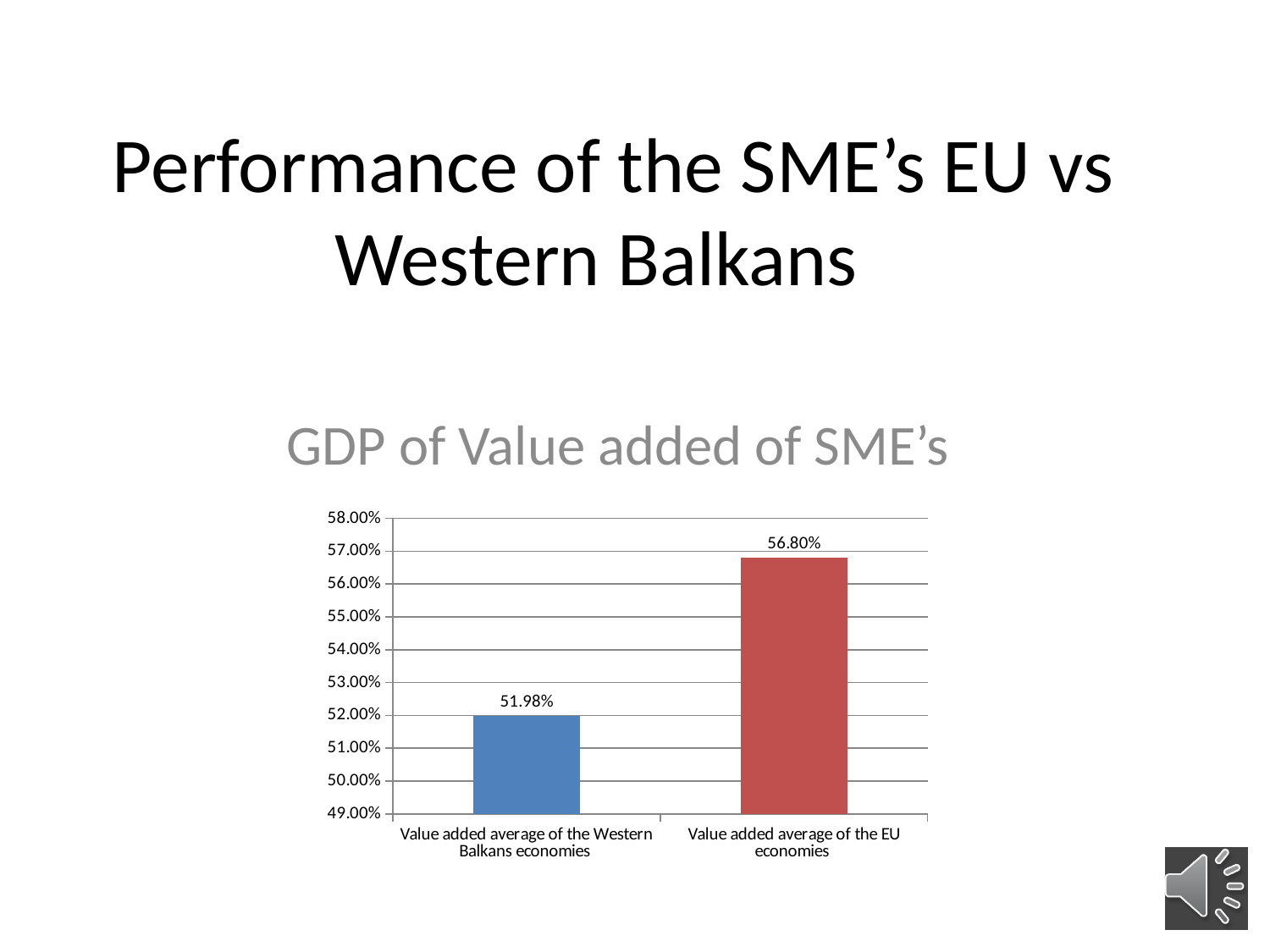
What kind of chart is shown on the slide? bar chart Which category has the higher value? Value added average of the EU economies How many categories are shown in the chart? 2 What is the value added average of the Western Balkans economies? 51.98% Is the value for the Western Balkans economies larger or smaller than the value for the EU economies? smaller Which category has the lower value? Value added average of the Western Balkans economies What is the title of the chart? GDP of Value added of SME's What is the difference between the EU economies value and the Western Balkans economies value? 4.82% What is the value added average of the EU economies? 56.80% Is the value for the EU economies greater or less than 55.00%? greater Is the value for the Western Balkans economies greater or less than 53.00%? less What colour is the bar for the EU economies? red